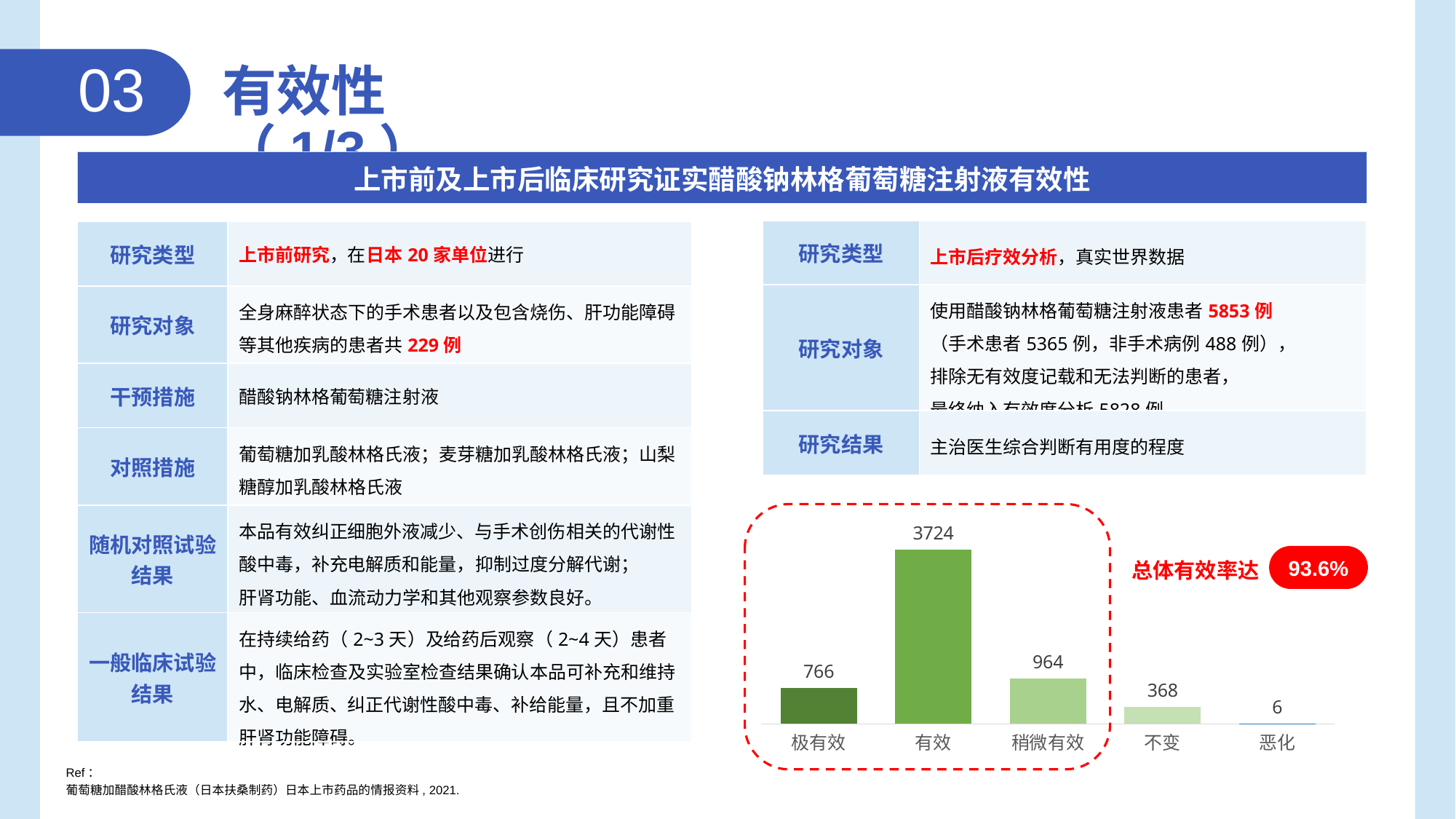
What kind of chart is shown on the slide? bar chart What is the value for 稍微有效 in the bar chart? 964 How many categories are shown in the bar chart? 5 What overall effectiveness rate (总体有效率) is shown next to the chart? 93.6% Which category has the highest value in the bar chart? 有效 What is the value for 有效 in the bar chart? 3724 What is the value for 不变 in the bar chart? 368 Which category has the lowest value in the bar chart? 恶化 Which is larger, the value for 稍微有效 or the value for 极有效? 稍微有效 What is the difference between the values for 有效 and 稍微有效? 2760 What is the value for 极有效 in the bar chart? 766 What is the value for 恶化 in the bar chart? 6